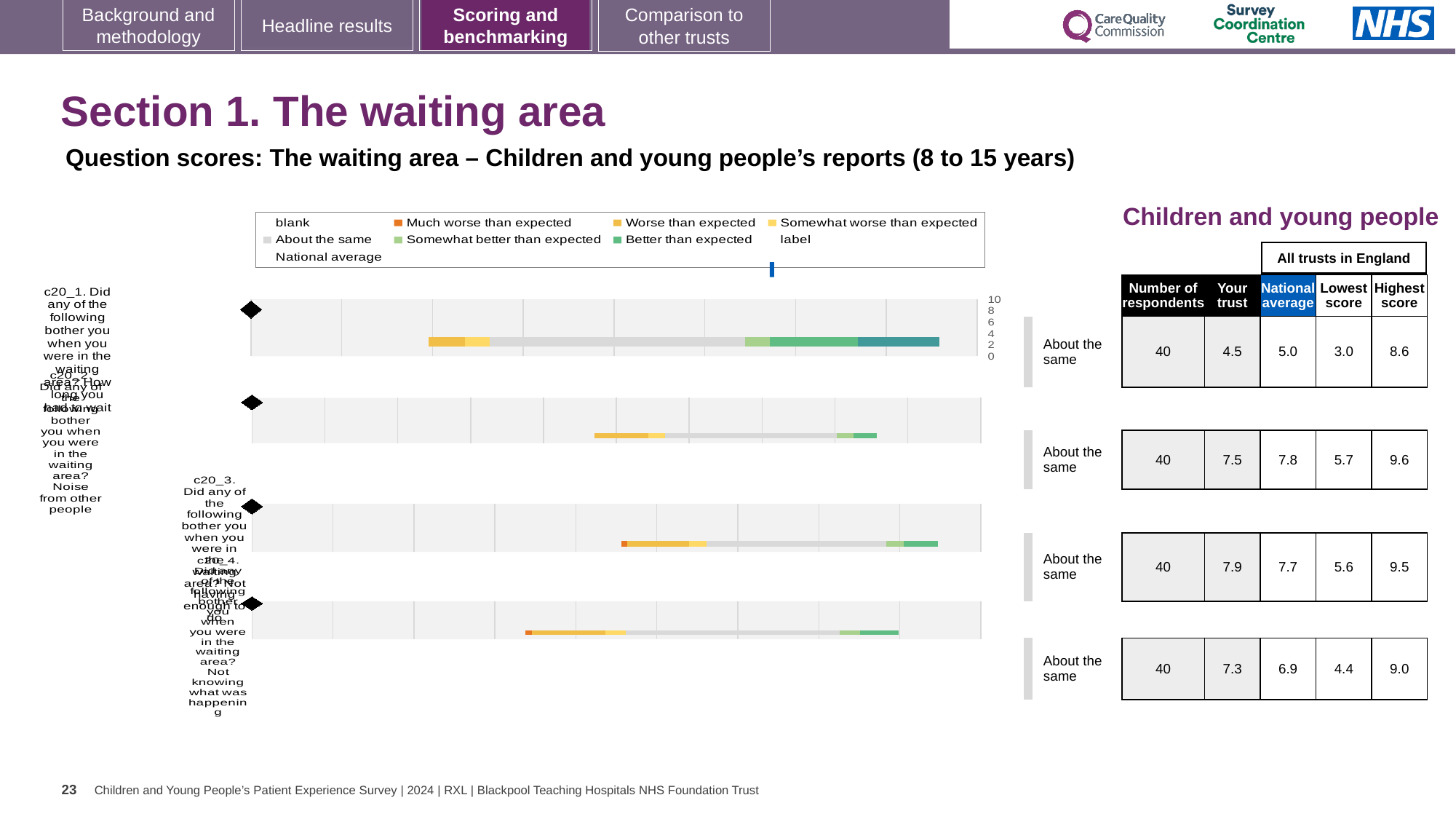
Which question has the lowest 'Your trust' score? c20_1. How long you had to wait For the question about not having enough to do (c20_3), which is larger: the 'Your trust' score or the national average? Your trust What benchmark category is shown next to each of the four question bars? About the same What kind of chart is used to show the question scores on this slide? Bar chart How many respondents answered each of the waiting area questions? 40 What is the 'Your trust' score for the question about how long you had to wait in the waiting area (c20_1)? 4.5 What is the national average score for the question about noise from other people in the waiting area (c20_2)? 7.8 How many question bars are plotted on the slide? 4 What is the difference between the highest score and the lowest score for the question about how long you had to wait (c20_1)? 5.6 How many entries does the legend above the charts list? 9 What is the difference between the 'Your trust' score and the national average for the question about not knowing what was happening (c20_4)? 0.4 Which question has the highest 'Your trust' score? c20_3. Not having enough to do